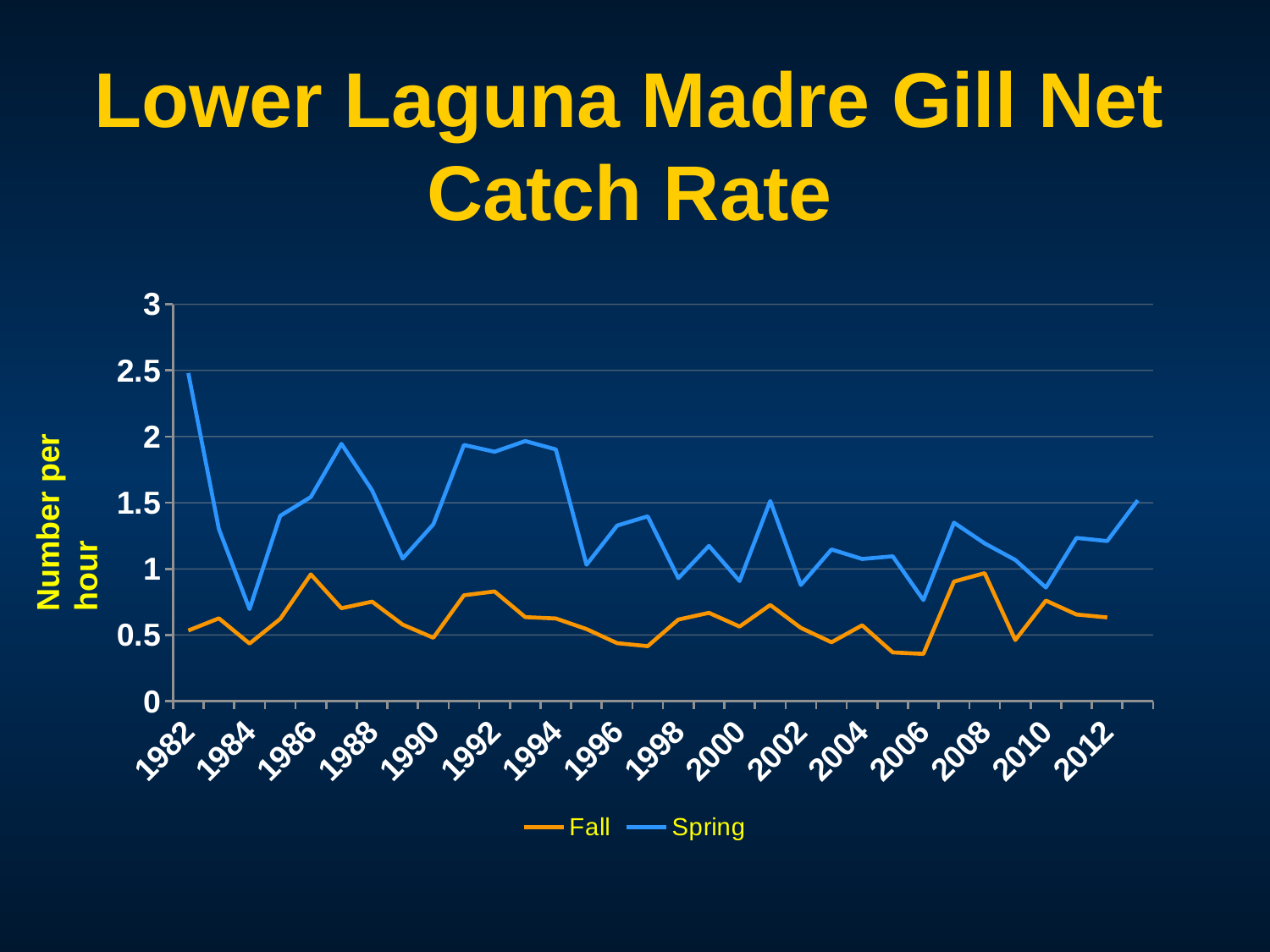
In 1992, which series has the larger value, Fall or Spring? Spring Is the Spring value for 2007 greater or less than 1? greater In which year does the Spring series reach its highest value? 1982 Is the Spring value for 1982 greater or less than 2? greater Does the Spring series rise or fall between 1982 and 1984? fall How many series does the legend list? 2 Is the Fall value for 2006 greater or less than 0.5? less What are the two series named in the legend? Fall and Spring What kind of chart is shown on the slide? line chart What is the label on the vertical axis? Number per hour